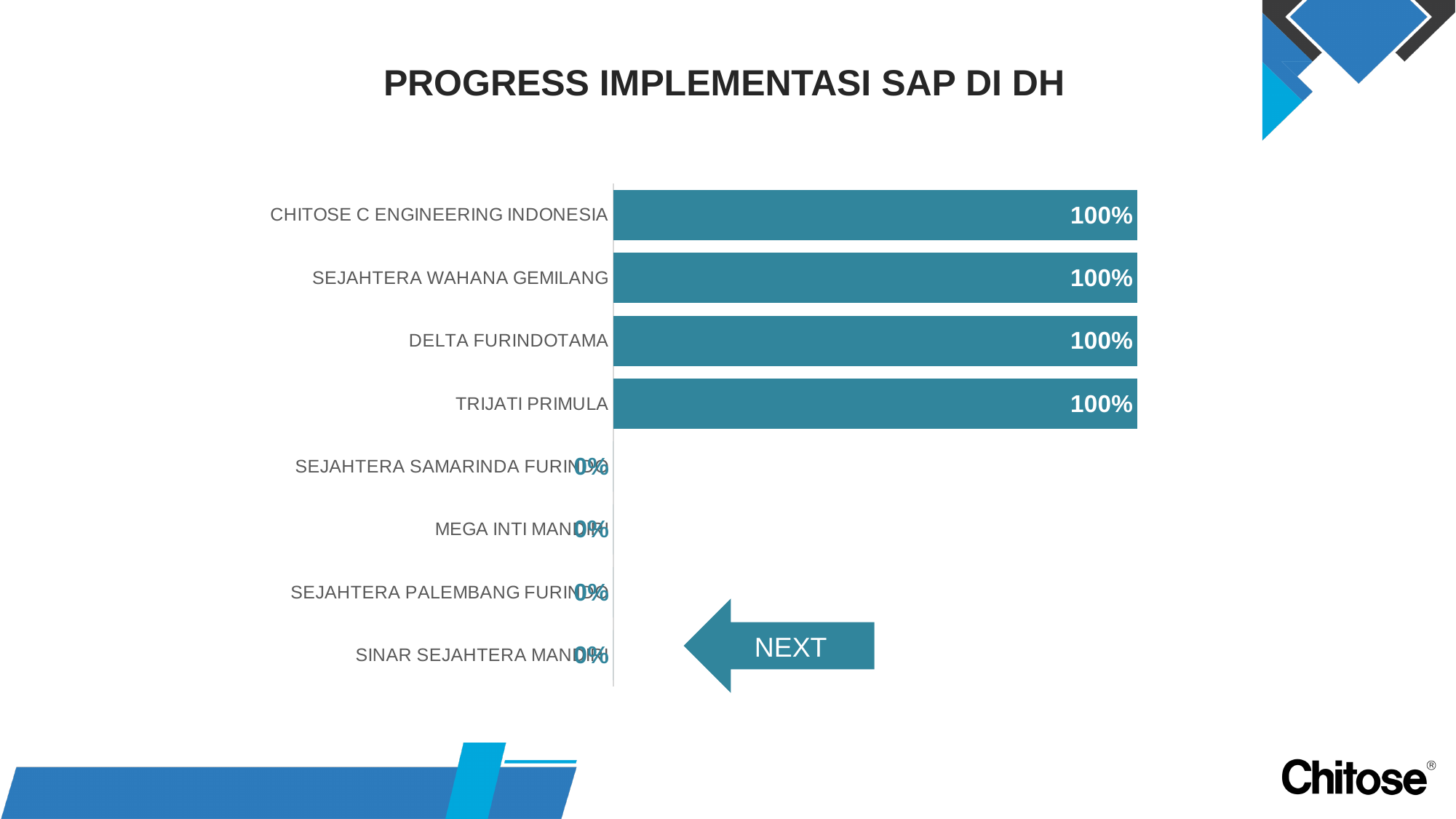
What colour are the bars in the chart? Teal blue How many categories have a value of 100%? 4 What is the value for TRIJATI PRIMULA? 100% What is the value for DELTA FURINDOTAMA? 100% What kind of chart is shown on the slide? Bar chart What is the title of the chart? PROGRESS IMPLEMENTASI SAP DI DH How many categories have a value of 0%? 4 Is the value for DELTA FURINDOTAMA larger than, smaller than, or equal to the value for SEJAHTERA WAHANA GEMILANG? Equal What is the value for CHITOSE C ENGINEERING INDONESIA? 100% What is the difference between the values for CHITOSE C ENGINEERING INDONESIA and TRIJATI PRIMULA? 0% How many categories are shown in the chart? 8 What is the value for SEJAHTERA WAHANA GEMILANG? 100%